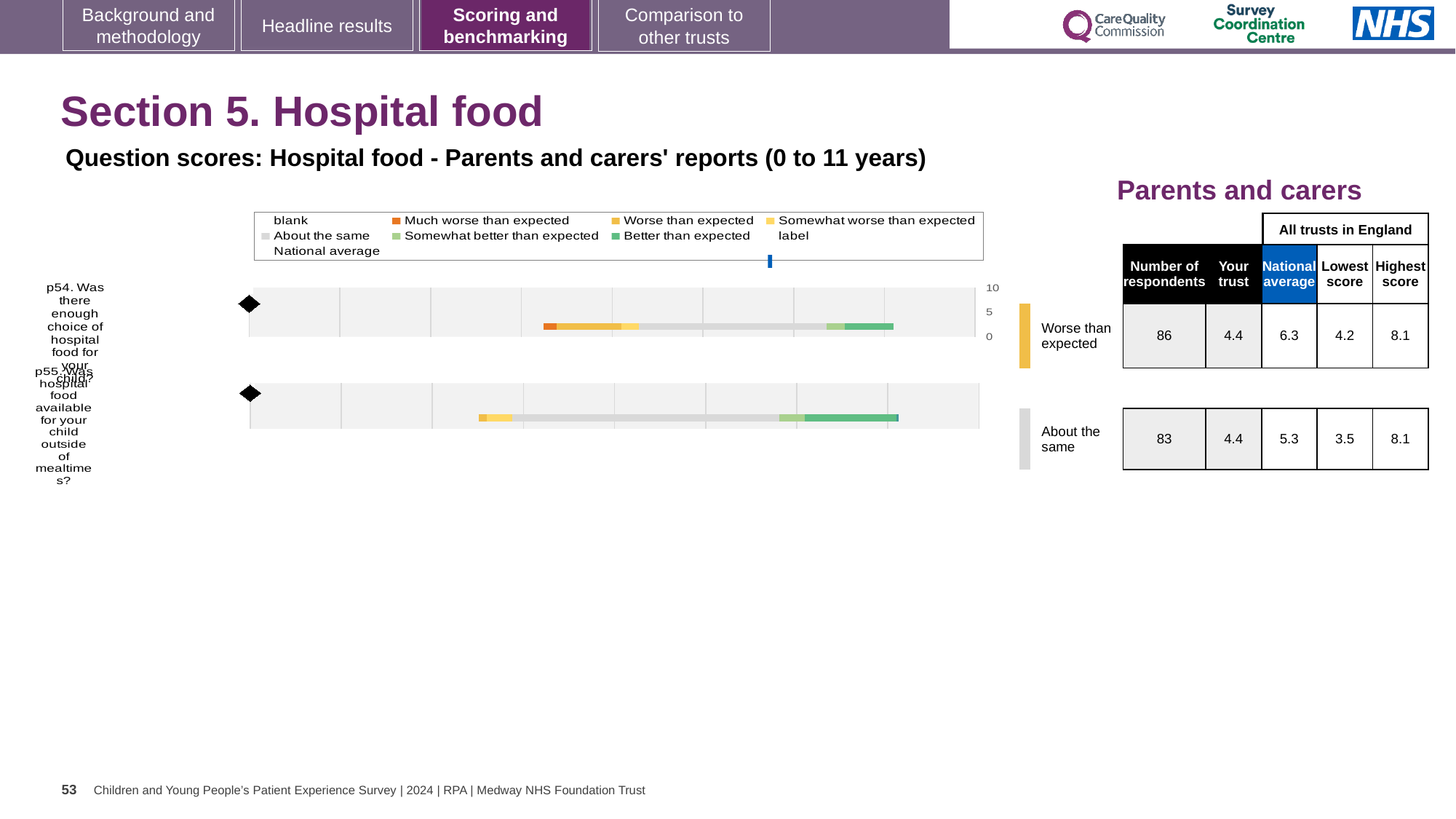
Which question has the higher national average score, p54 (enough choice of hospital food) or p55 (food available outside of mealtimes)? p54 What benchmark category is p54 (enough choice of hospital food for your child) assigned to? Worse than expected What is the difference between the national average and the 'Your trust' score for p54 (enough choice of hospital food for your child)? 1.9 How many questions (categories) are plotted in the chart? 2 How many entries does the chart legend list? 9 What is the lowest score across all trusts in England for p55 (hospital food available outside of mealtimes)? 3.5 How many respondents answered p55 (hospital food available outside of mealtimes)? 83 What type of chart is shown on the slide? bar chart What is the highest score across all trusts in England for p54 (enough choice of hospital food for your child)? 8.1 What is the national average score for p54 (enough choice of hospital food for your child)? 6.3 What benchmark category is p55 (hospital food available outside of mealtimes) assigned to? About the same What is the 'Your trust' score for p54 (enough choice of hospital food for your child)? 4.4